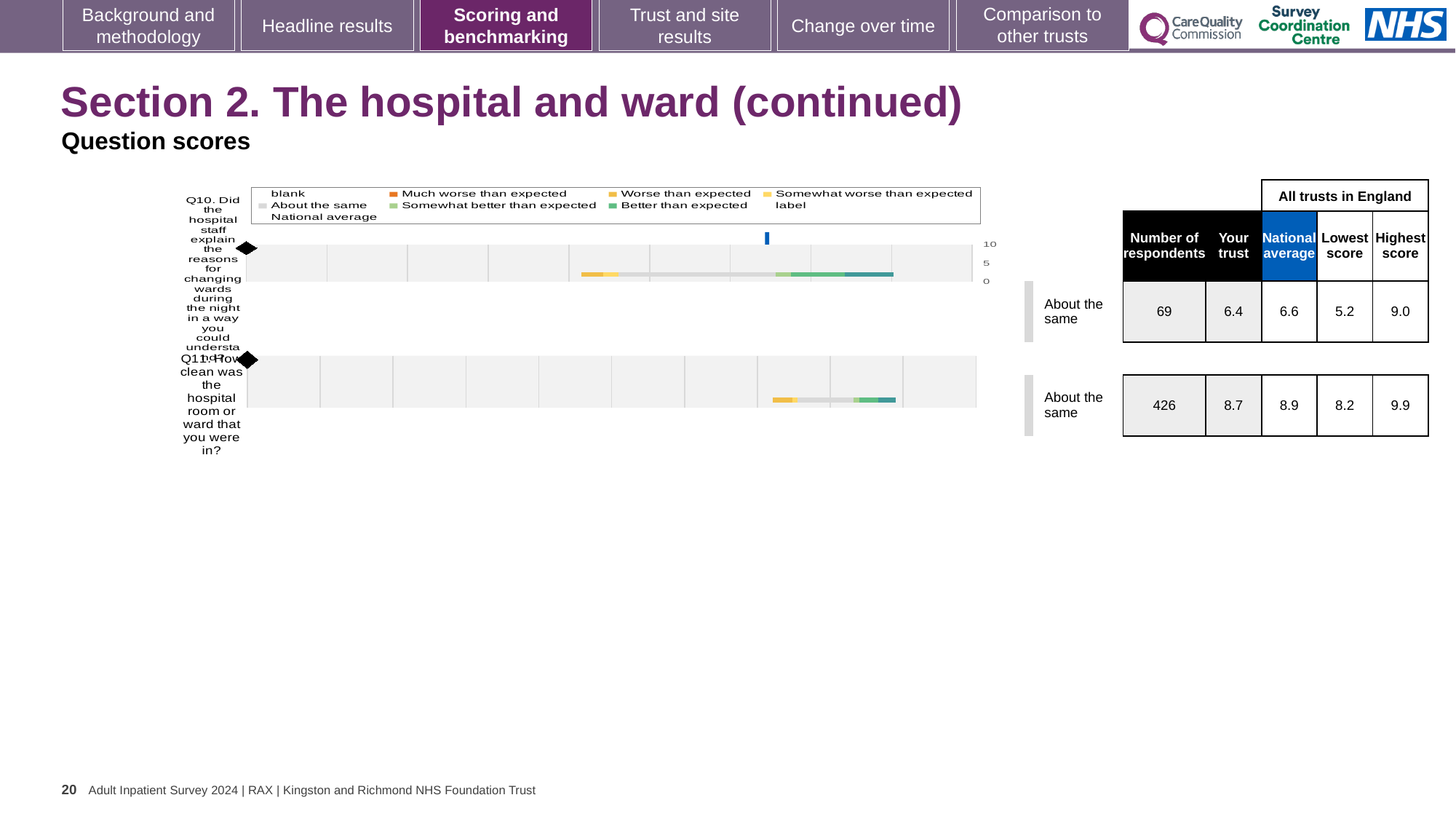
What is the lowest score among all trusts in England for Q10? 5.2 What is the difference between the highest and lowest trust scores for Q11? 1.7 How many survey questions are plotted in the chart? 2 Which question has the higher 'Your trust' score, Q10 or Q11? Q11 How many respondents answered Q11? 426 What is the 'Your trust' score for Q10 (explaining reasons for changing wards during the night)? 6.4 What benchmark category is the trust's Q10 score placed in? About the same What kind of chart is used to show the question scores on this slide? bar chart For Q10, which is larger: the trust's score or the national average? National average Is the trust's score for Q11 greater or less than 5 on the chart axis? greater By how much does the national average exceed the trust's score for Q10? 0.2 What is the national average score for Q11 (how clean was the hospital room or ward)? 8.9